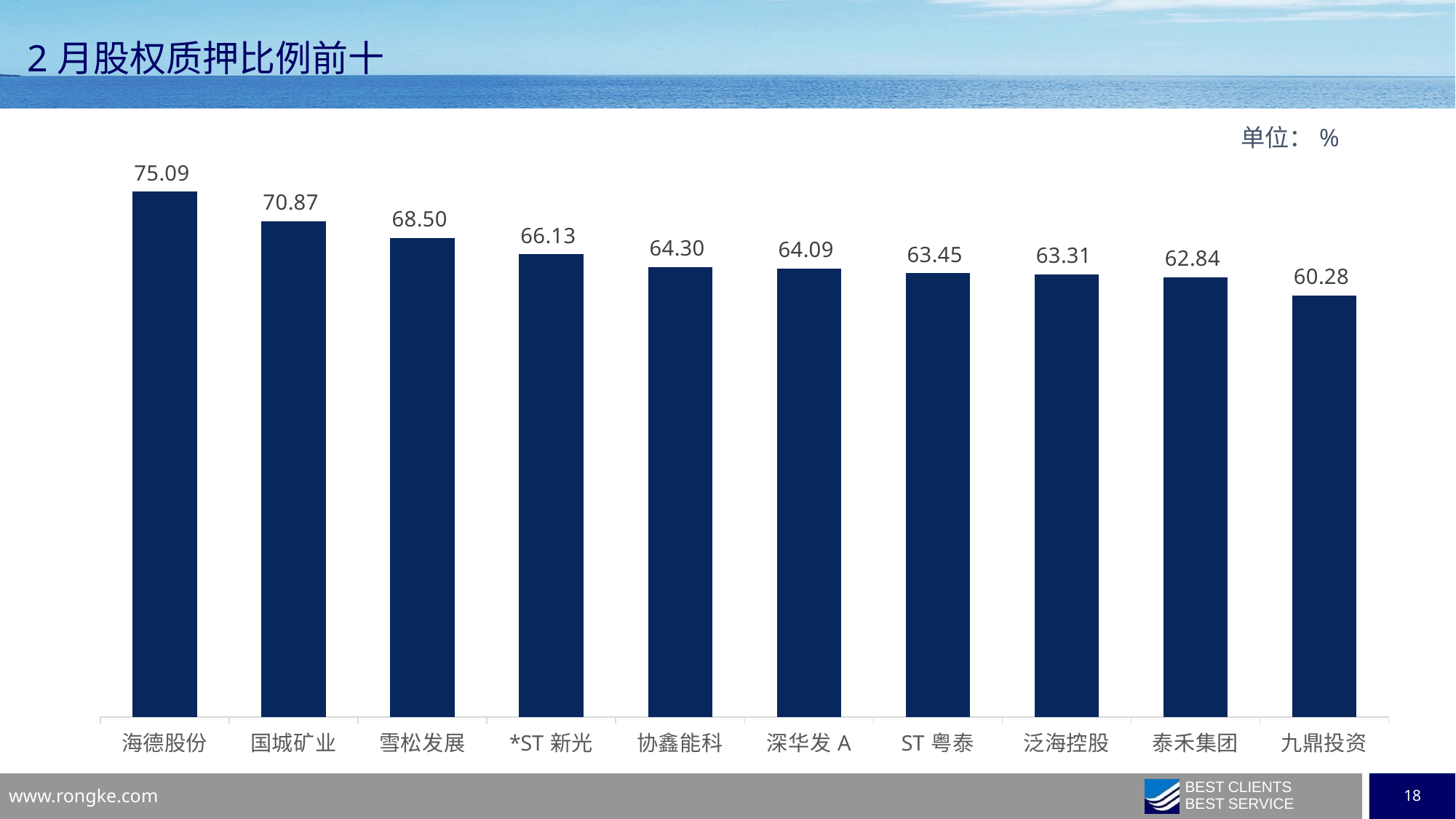
Which is larger, the value for 国城矿业 or the value for *ST 新光? 国城矿业 What kind of chart is shown on the slide? bar chart What unit is indicated for the values in the chart? % What is the value for 泰禾集团? 62.84 What is the value for 协鑫能科? 64.30 What is the difference between the values for 海德股份 and 国城矿业? 4.22 Which category has the lowest value? 九鼎投资 Which category has the highest value? 海德股份 Do the values rise or fall from left to right along the x axis? fall What is the difference between the values for 雪松发展 and 九鼎投资? 8.22 How many categories are shown in the chart? 10 What is the value for 海德股份? 75.09